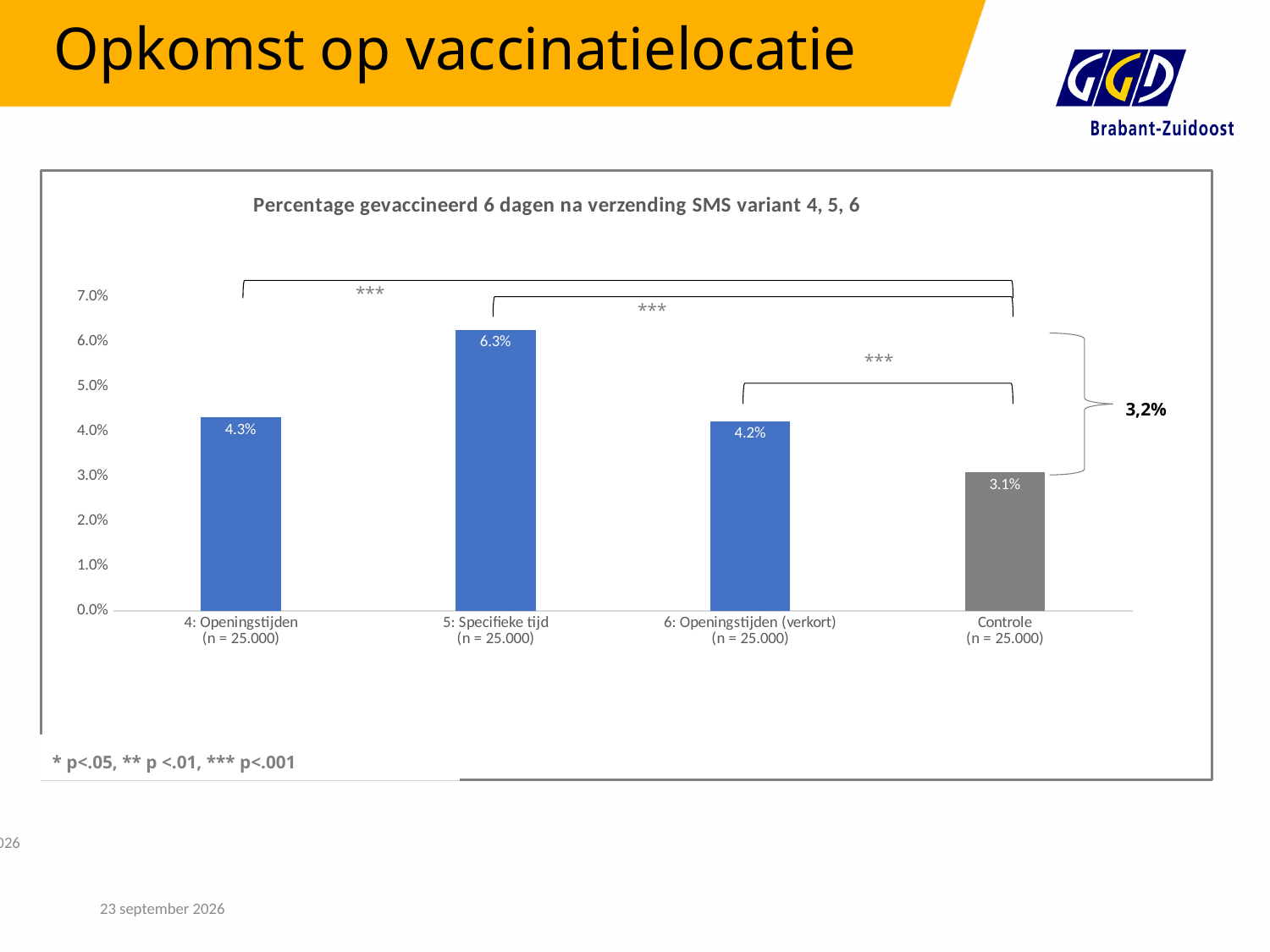
What kind of chart is shown? Bar chart What is the difference between '5: Specifieke tijd' and 'Controle'? 3.2% What is the value for '6: Openingstijden (verkort)'? 4.2% What is the value for '5: Specifieke tijd'? 6.3% How many categories are shown on the x axis? 4 Which is larger: the value for '5: Specifieke tijd' or the value for '4: Openingstijden'? 5: Specifieke tijd What is the difference between '4: Openingstijden' and '6: Openingstijden (verkort)'? 0.1% What is the value for '4: Openingstijden'? 4.3% Which category has the highest percentage? 5: Specifieke tijd What is the value for 'Controle'? 3.1% Which category has the lowest percentage? Controle What is the title of the chart? Percentage gevaccineerd 6 dagen na verzending SMS variant 4, 5, 6